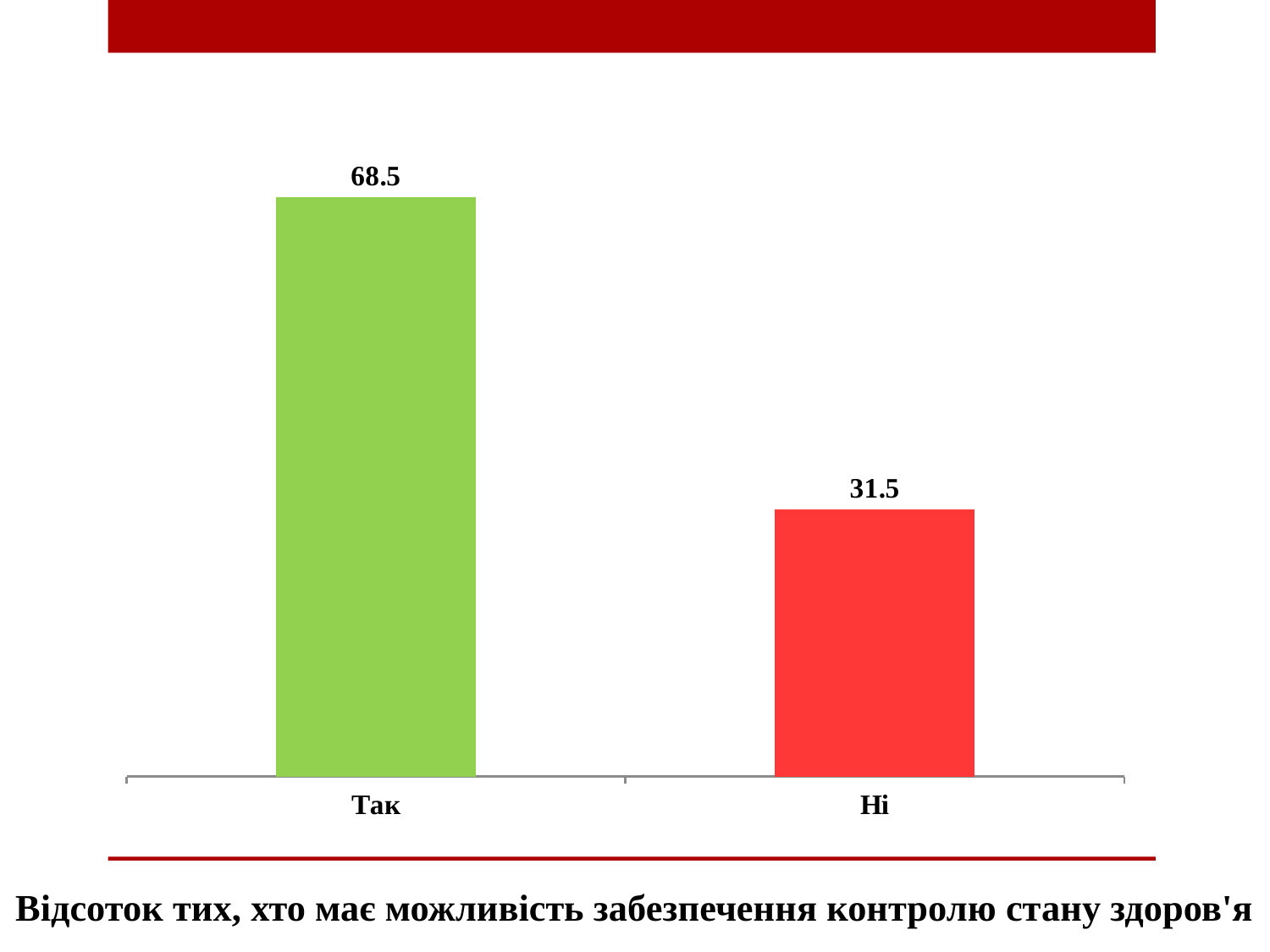
What is the total of the two bar values? 100 What kind of chart is shown on the slide? Bar chart What is the value for "Ні"? 31.5 Which category has the highest value? Так What colour is the bar for "Ні"? Red Which is larger, the value for "Так" or the value for "Ні"? Так Which category has the lowest value? Ні What is the difference between the values for "Так" and "Ні"? 37 What is the value for "Так"? 68.5 What colour is the bar for "Так"? Green How many categories are shown on the x axis? 2